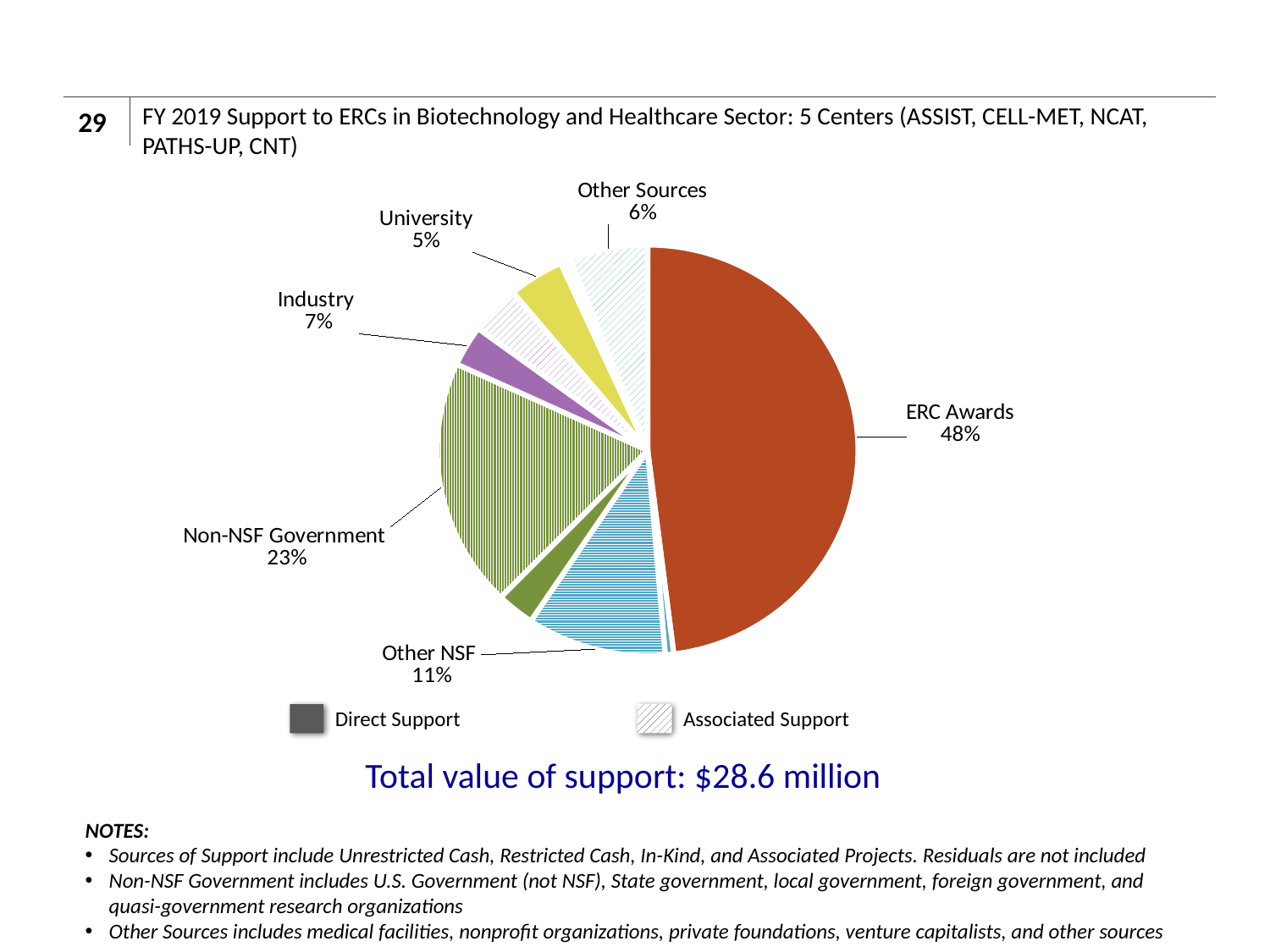
What percentage of support is from Non-NSF Government? 23% How many entries does the legend below the pie chart list? 2 What kind of chart is shown on the slide? pie chart How many labeled sources of support are shown in the pie chart? 6 Which is larger, the share for Other Sources or the share for University? Other Sources What percentage of support comes from Industry? 7% What share of support comes from Other NSF? 11% Which source of support has the largest share of the pie? ERC Awards How many percentage points larger is the ERC Awards share than the Non-NSF Government share? 25 What share of support comes from ERC Awards? 48% What is the total value of support stated below the chart? $28.6 million Which source of support has the smallest share of the pie? University